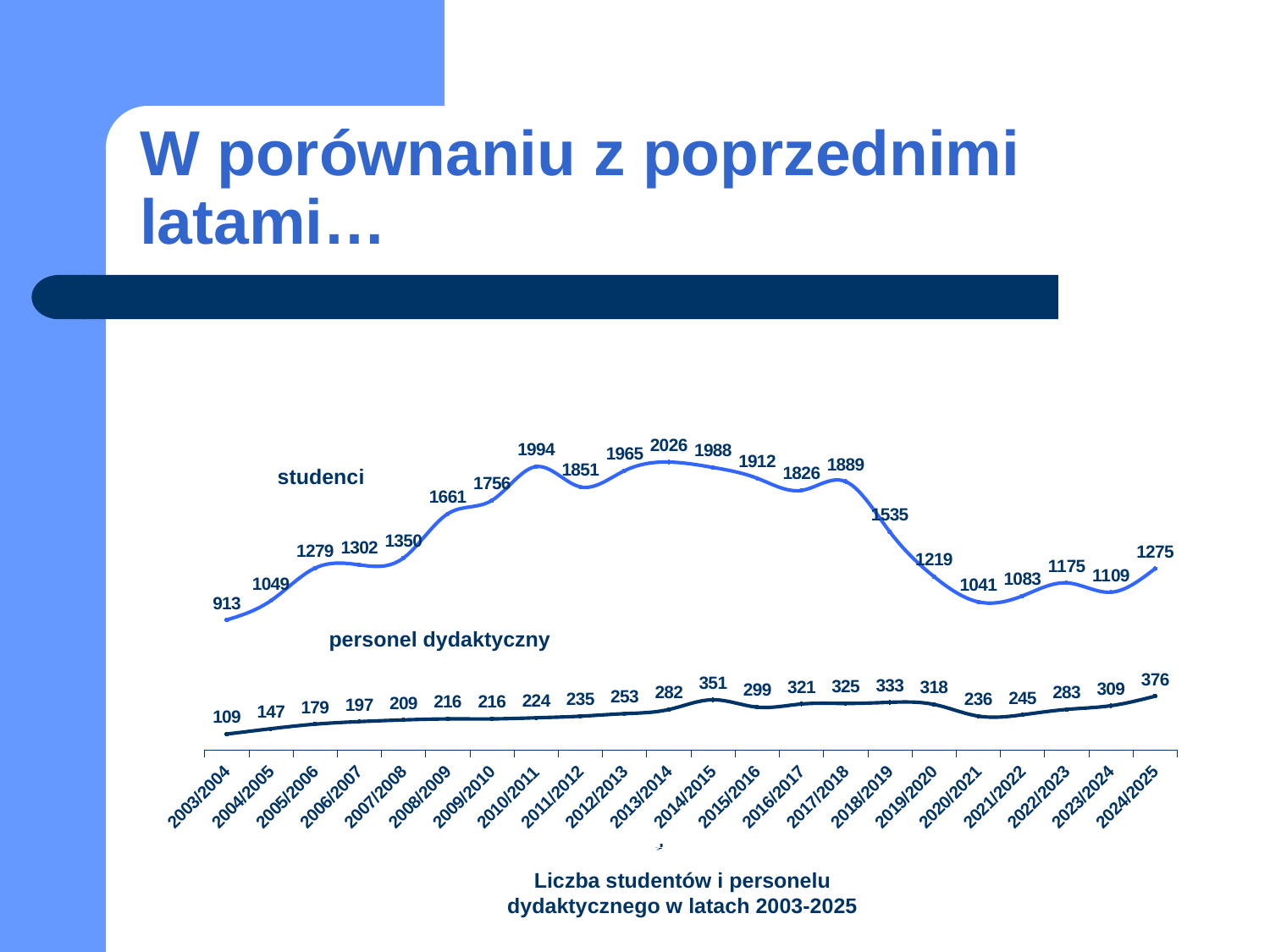
What is the number of students in 2020/2021? 1041 What is the number of teaching staff (personel dydaktyczny) in 2024/2025? 376 Which is larger: the number of teaching staff in 2014/2015 or in 2015/2016? 2014/2015 What is the highest value of the studenci series? 2026 What type of chart is shown on the slide? line chart What is the caption printed below the chart? Liczba studentów i personelu dydaktycznego w latach 2003-2025 How many data series does the chart show? 2 What is the difference between the number of students in 2017/2018 and 2018/2019? 354 What is the number of students (studenci) in 2003/2004? 913 In which academic year is the number of students highest? 2013/2014 In which academic year is the number of teaching staff lowest? 2003/2004 How many academic years are shown on the x axis of the chart? 22